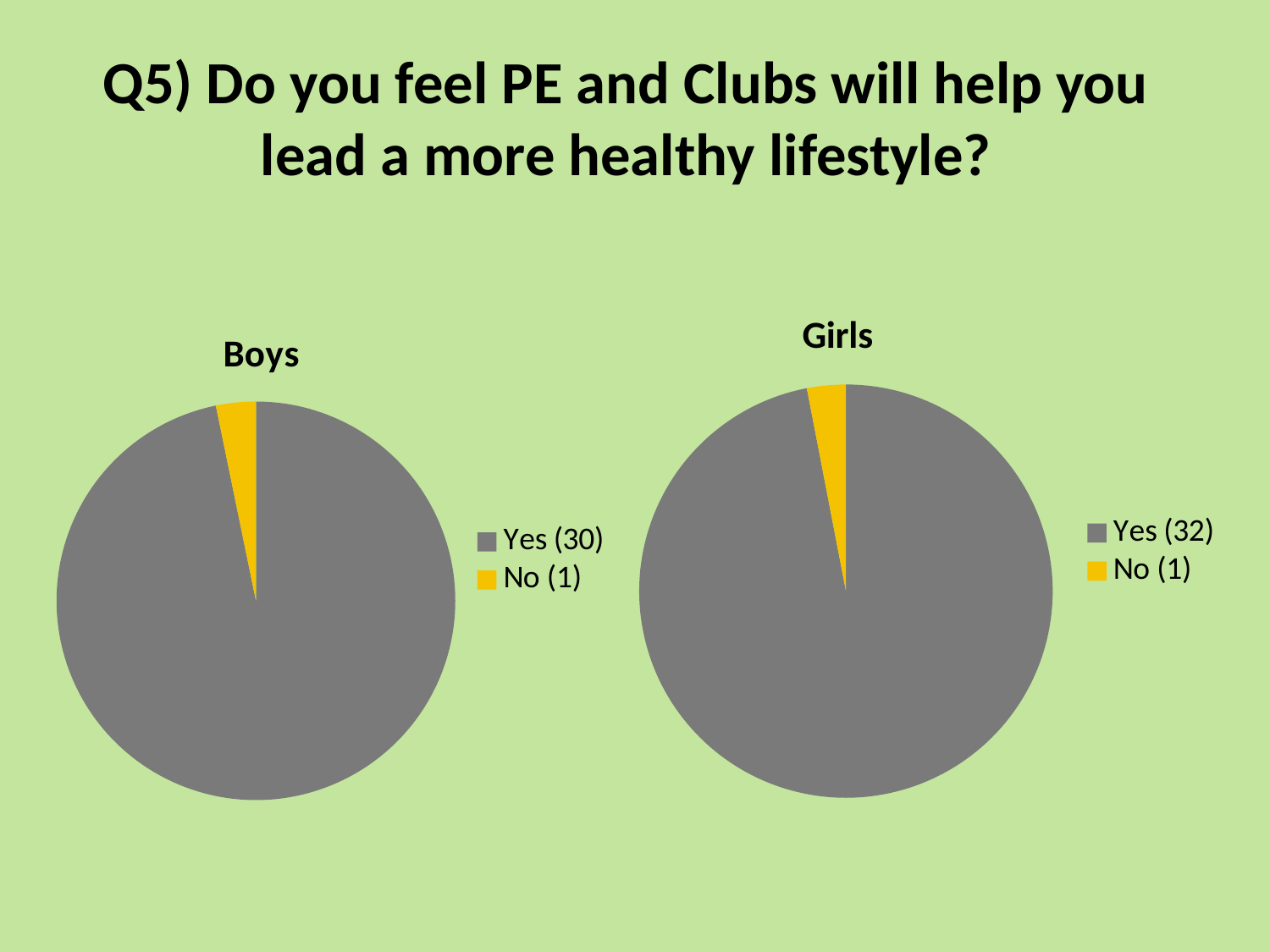
In the Girls chart, which response has the smallest slice? No In the Boys chart, what is the difference between the number of Yes and No responses? 29 In the Boys chart, how many boys answered Yes? 30 What type of chart is the Boys chart? Pie chart In the Girls chart, what colour is the No slice? Yellow In the Girls chart, how many girls answered No? 1 In the Girls chart, what is the difference between the number of Yes and No responses? 31 In the Boys chart, which response has the largest slice? Yes How many categories does the Girls chart legend list? 2 Which chart has more Yes responses, Boys or Girls? Girls In the Boys chart, how many boys answered No? 1 In the Girls chart, how many girls answered Yes? 32